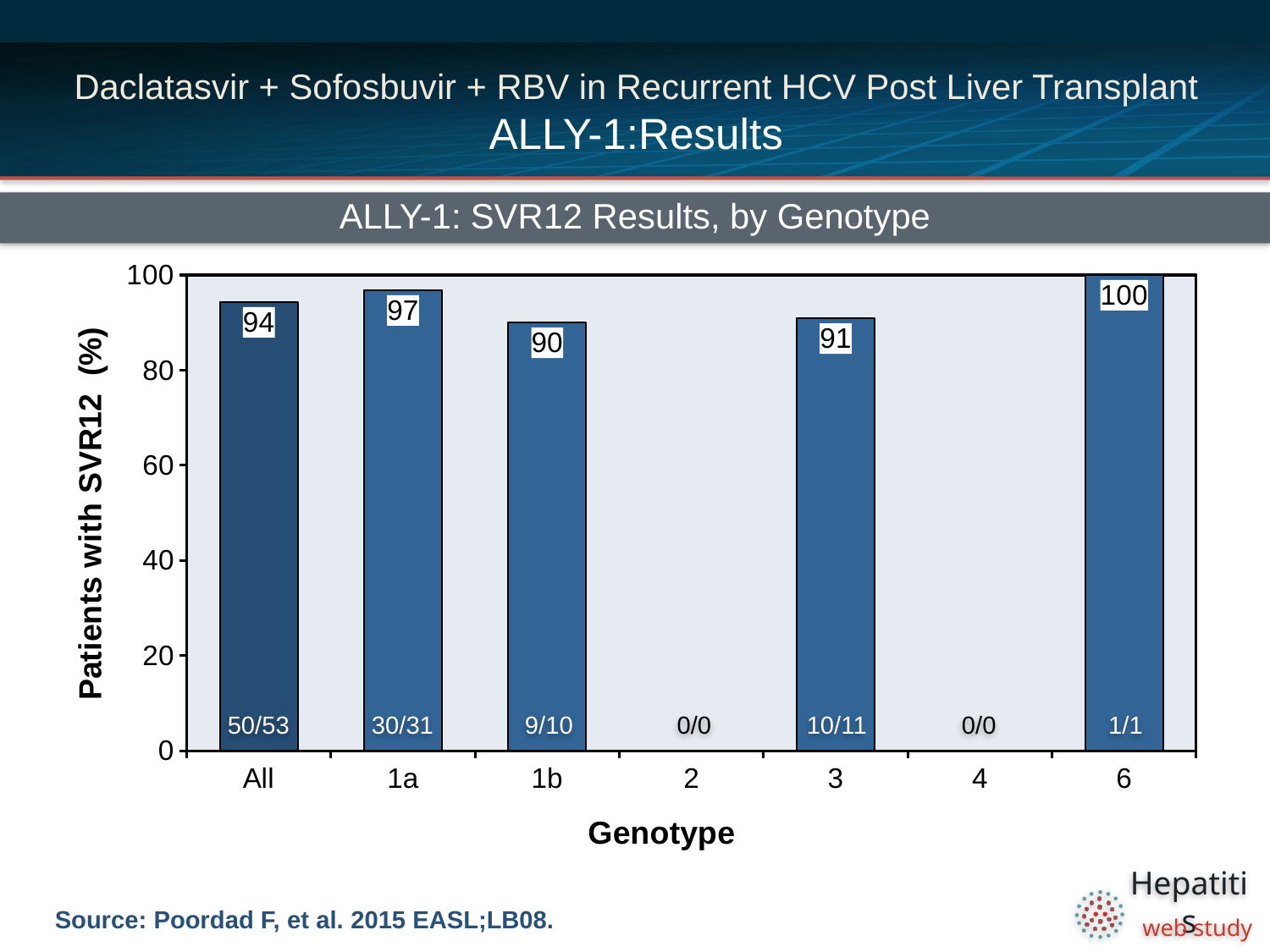
What is the SVR12 rate for genotype 3? 91 Which genotype has the highest SVR12 rate? 6 Which has a higher SVR12 rate, genotype 3 or genotype 1b? Genotype 3 What is the title of the chart? ALLY-1: SVR12 Results, by Genotype How many genotype categories are shown on the x axis? 7 What kind of chart is shown on the slide? Bar chart Among the genotypes with a plotted bar, which has the lowest SVR12 rate? 1b What is the SVR12 rate for genotype 1b? 90 What is the patient fraction shown for genotype 1a? 30/31 What is the SVR12 rate for genotype 1a? 97 What is the difference in SVR12 rate between genotype 1a and genotype 1b? 7 What is the SVR12 rate for the All group? 94